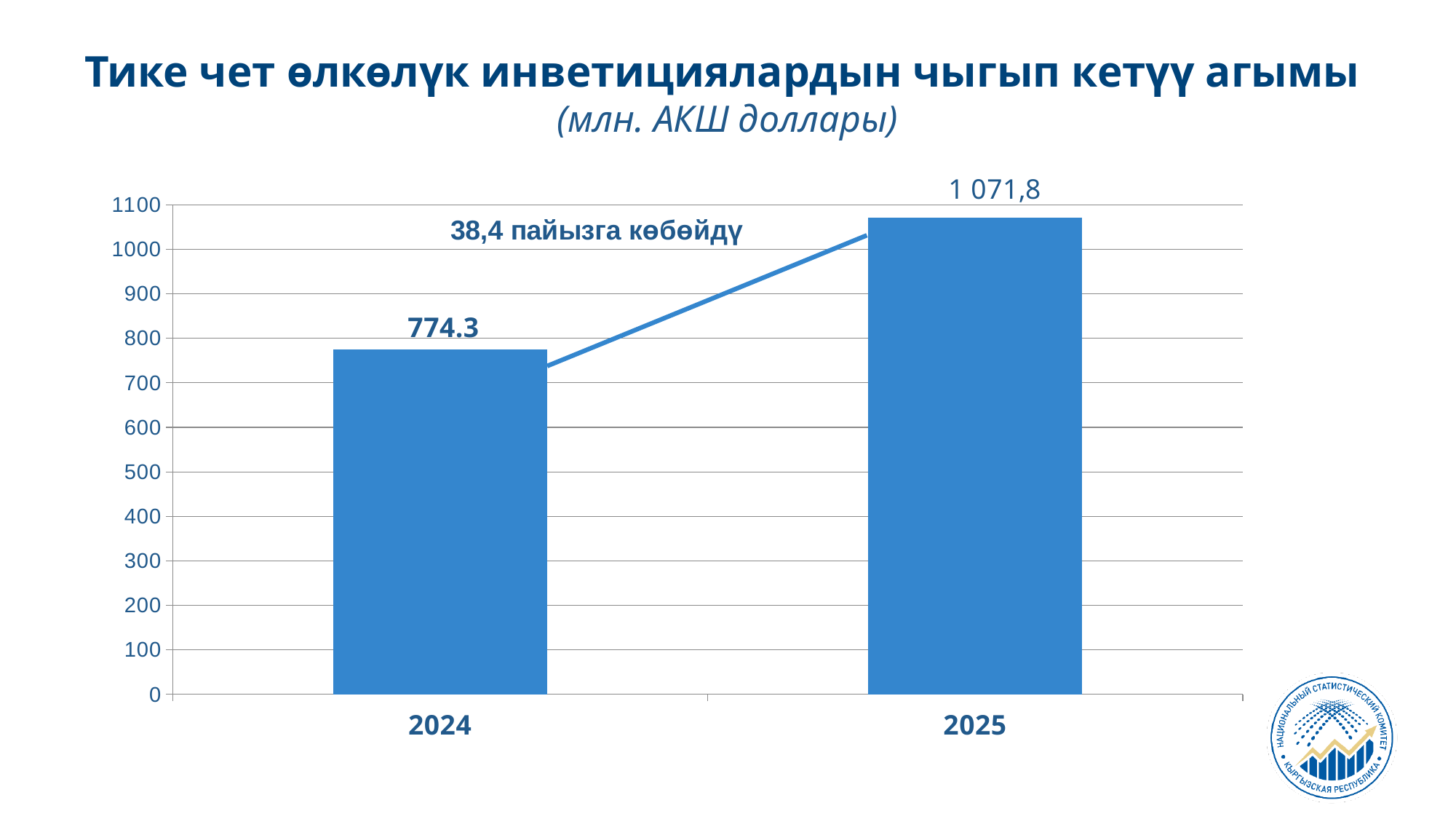
What is the difference between the 2025 value and the 2024 value? 297.5 How many bars are shown in the chart? 2 Which year has the higher value? 2025 Is the value for 2025 larger than the value for 2024? Yes Is the value for 2024 greater or less than 800? less What is the value for 2025? 1 071,8 What is the value for 2024? 774.3 Is the value for 2025 greater or less than 1000? greater What kind of chart is shown on the slide? Bar chart What percentage increase is annotated on the chart between 2024 and 2025? 38,4 пайызга көбөйдү Do the values rise or fall from 2024 to 2025? Rise Which year has the lower value? 2024